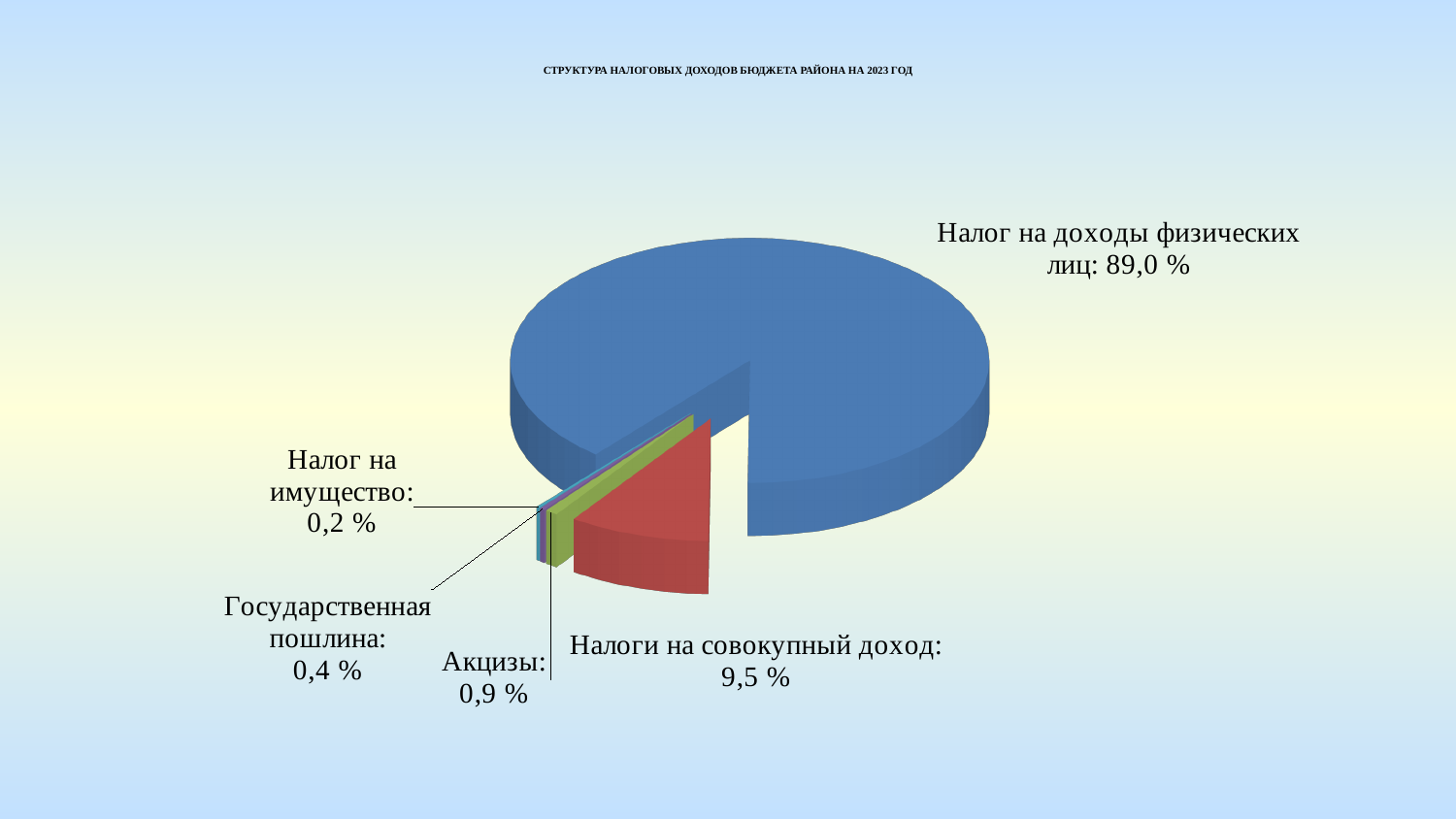
Какова доля налога на доходы физических лиц? 89,0 % Какая категория имеет наименьшую долю? Налог на имущество Что больше: доля акцизов или доля государственной пошлины? Акцизы Как называется диаграмма? СТРУКТУРА НАЛОГОВЫХ ДОХОДОВ БЮДЖЕТА РАЙОНА НА 2023 ГОД На сколько процентных пунктов доля налога на доходы физических лиц больше доли налогов на совокупный доход? 79,5 Какова доля акцизов? 0,9 % Какая категория имеет наибольшую долю? Налог на доходы физических лиц Сколько категорий показано на диаграмме? 5 Какова доля налогов на совокупный доход? 9,5 % Какова доля налога на имущество? 0,2 % Какой тип диаграммы показан на слайде? Круговая диаграмма Какова доля государственной пошлины? 0,4 %